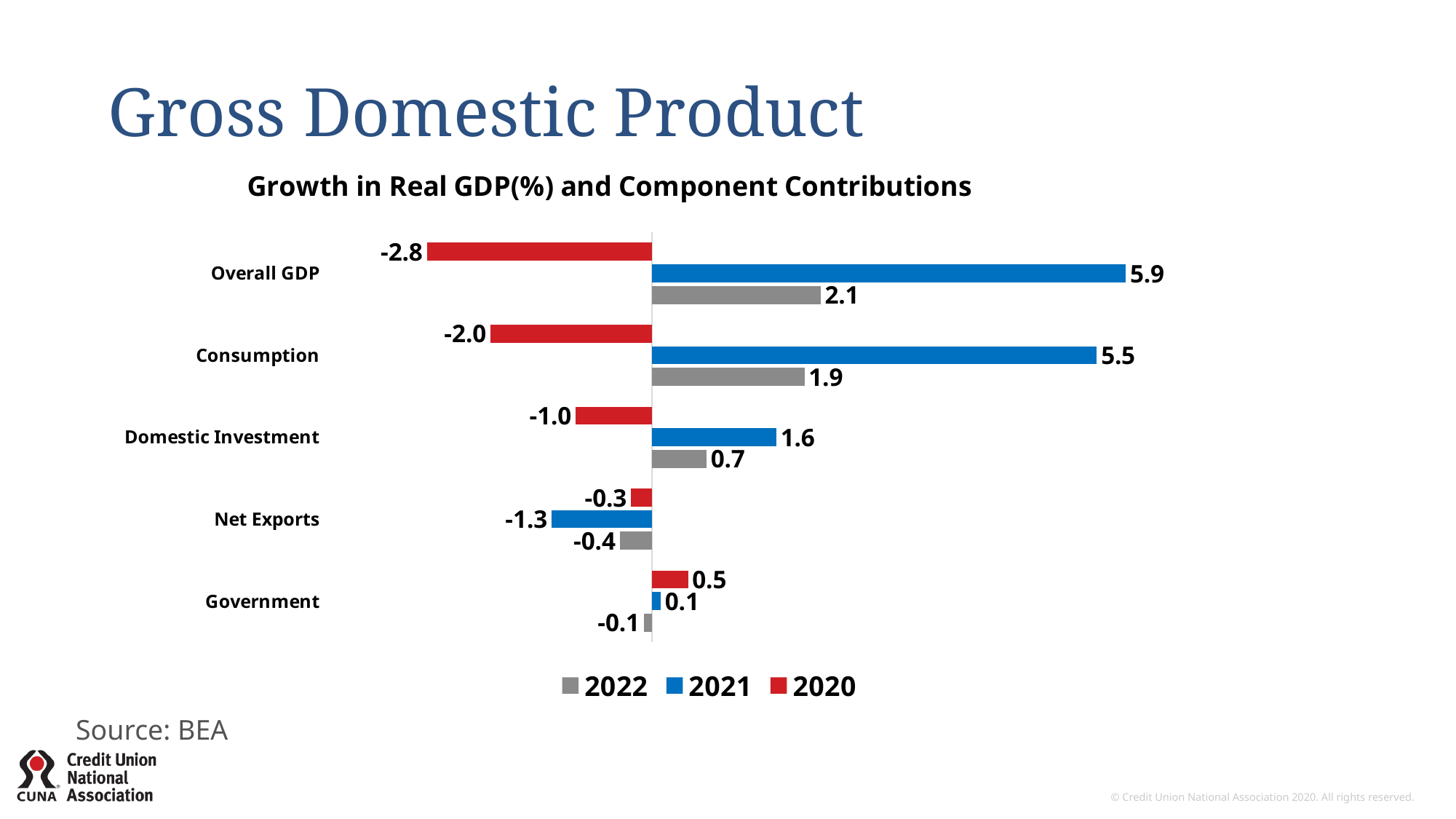
How many categories are shown on the chart? 5 Which category has the highest 2021 value? Overall GDP Which category has the lowest 2020 value? Overall GDP Which is larger, the 2022 value for Consumption or the 2022 value for Domestic Investment? Consumption What kind of chart is shown on the slide? Bar chart What is the difference between the 2021 and 2022 values for Overall GDP? 3.8 What is the 2021 value for Net Exports? -1.3 What is the 2021 value for Overall GDP? 5.9 What is the 2020 value for Government? 0.5 How many series does the legend list? 3 What is the 2020 value for Consumption? -2.0 What is the 2022 value for Domestic Investment? 0.7